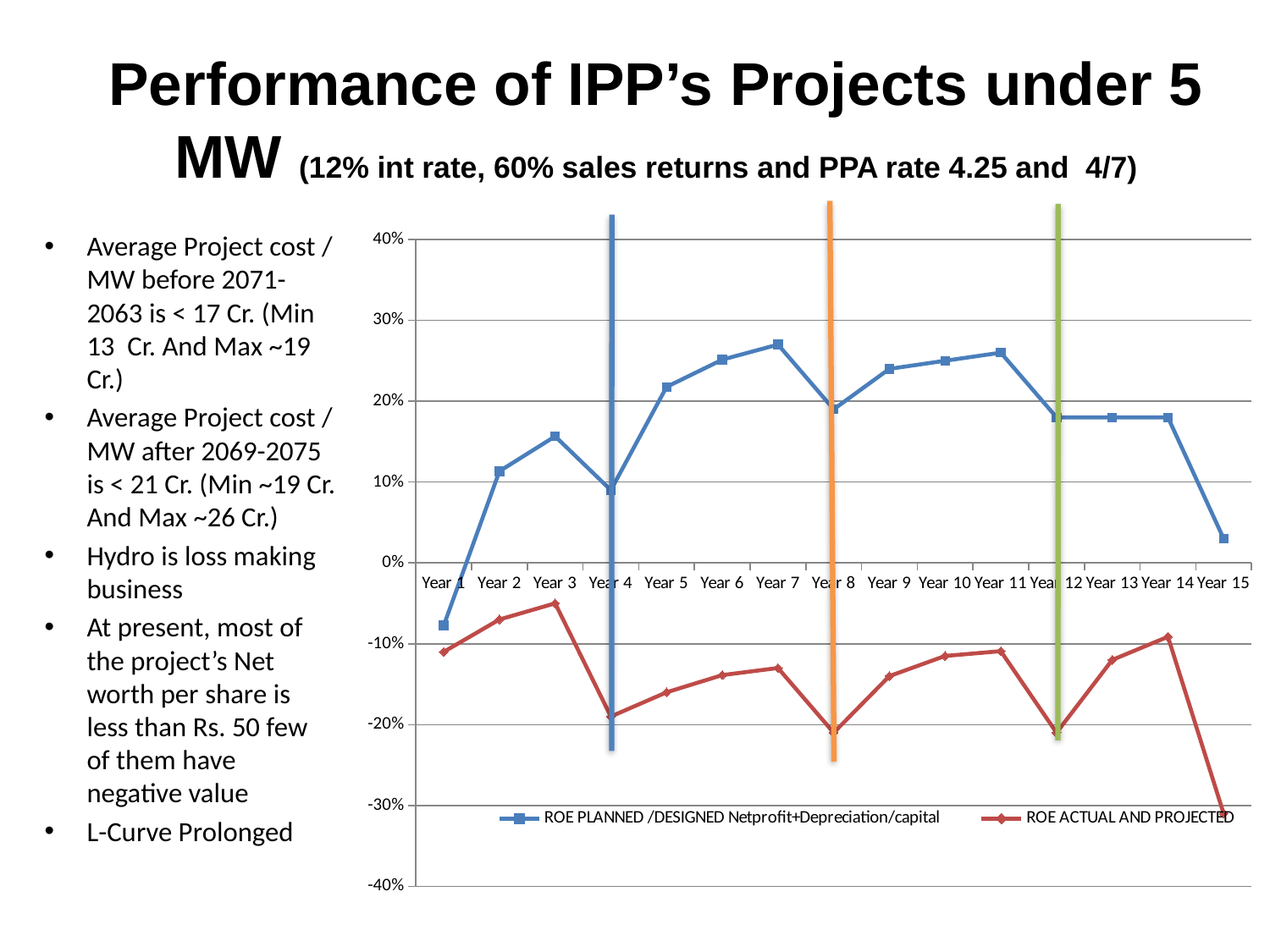
How many series does the chart legend list? 2 What kind of chart is shown on the slide? line chart Which year has the highest value for the ROE ACTUAL AND PROJECTED series? Year 3 How many years are plotted along the x axis of the chart? 15 Which year has the lowest value for the ROE ACTUAL AND PROJECTED series? Year 15 Is the ROE PLANNED /DESIGNED value for Year 15 greater or less than 10%? less Is the ROE PLANNED /DESIGNED value for Year 7 greater or less than 20%? greater Is the ROE ACTUAL AND PROJECTED value for Year 4 greater or less than -10%? less Which year has the lowest value for the ROE PLANNED /DESIGNED series? Year 1 At Year 7, which series has the larger value: ROE PLANNED /DESIGNED or ROE ACTUAL AND PROJECTED? ROE PLANNED /DESIGNED Does the ROE PLANNED /DESIGNED series rise or fall from Year 11 to Year 15? fall What colour is the line for the ROE ACTUAL AND PROJECTED series? red